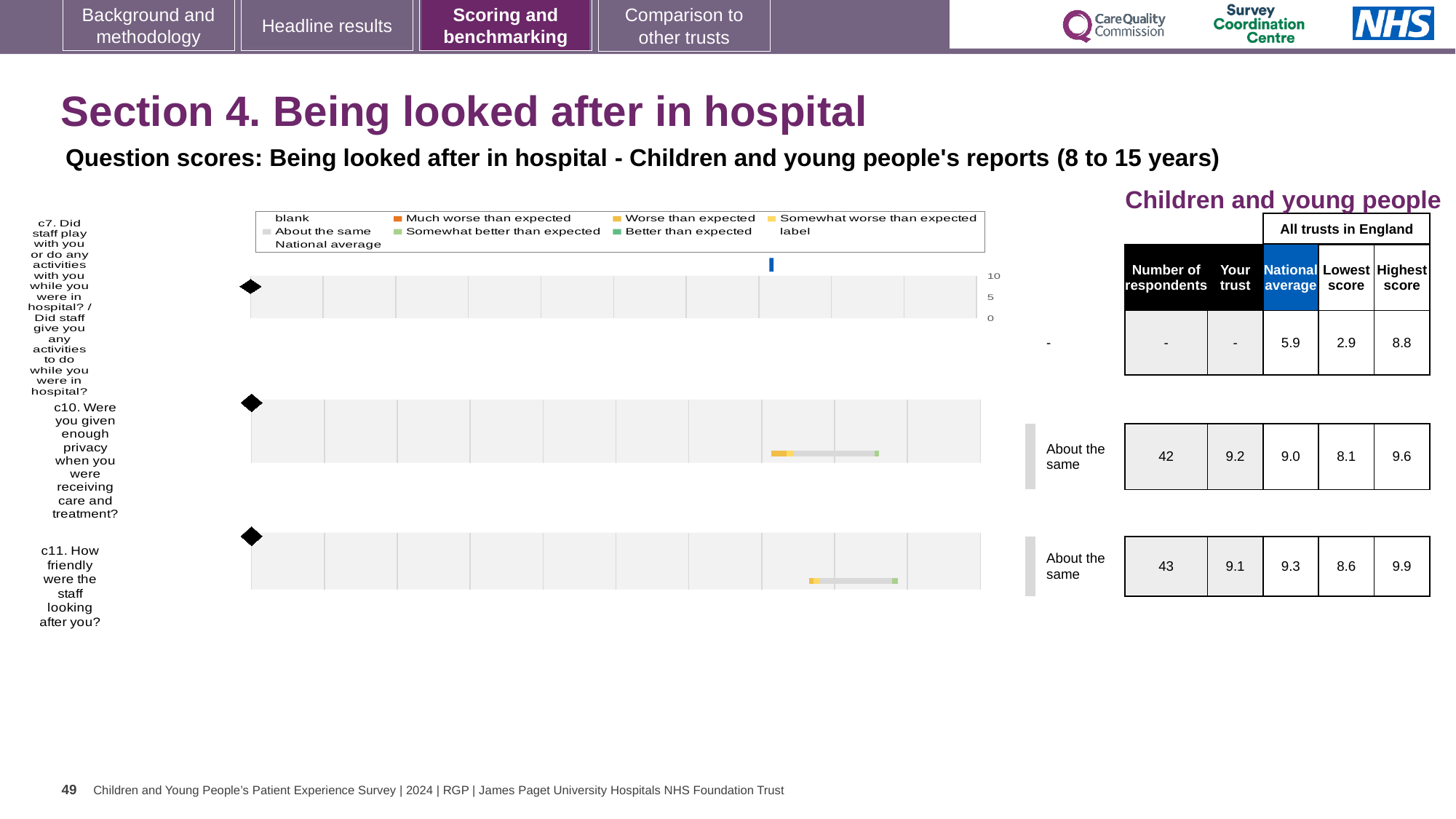
What is the lowest score across all trusts in England for c7? 2.9 What is the difference between the national average and the 'Your trust' score for c11? 0.2 What is the difference between the highest and lowest scores for c10? 1.5 What benchmark label is shown for c10? About the same What is the 'Your trust' score for c10 (Were you given enough privacy when you were receiving care and treatment?)? 9.2 What is the highest score across all trusts in England for c7? 8.8 What kind of chart is shown on the slide? bar chart What is the national average score for c11 (How friendly were the staff looking after you?)? 9.3 Which has the higher 'Your trust' score, c10 or c11? c10 What is the maximum value shown on the chart's score axis? 10 How many respondents answered c11? 43 How many survey questions are plotted in the chart? 3